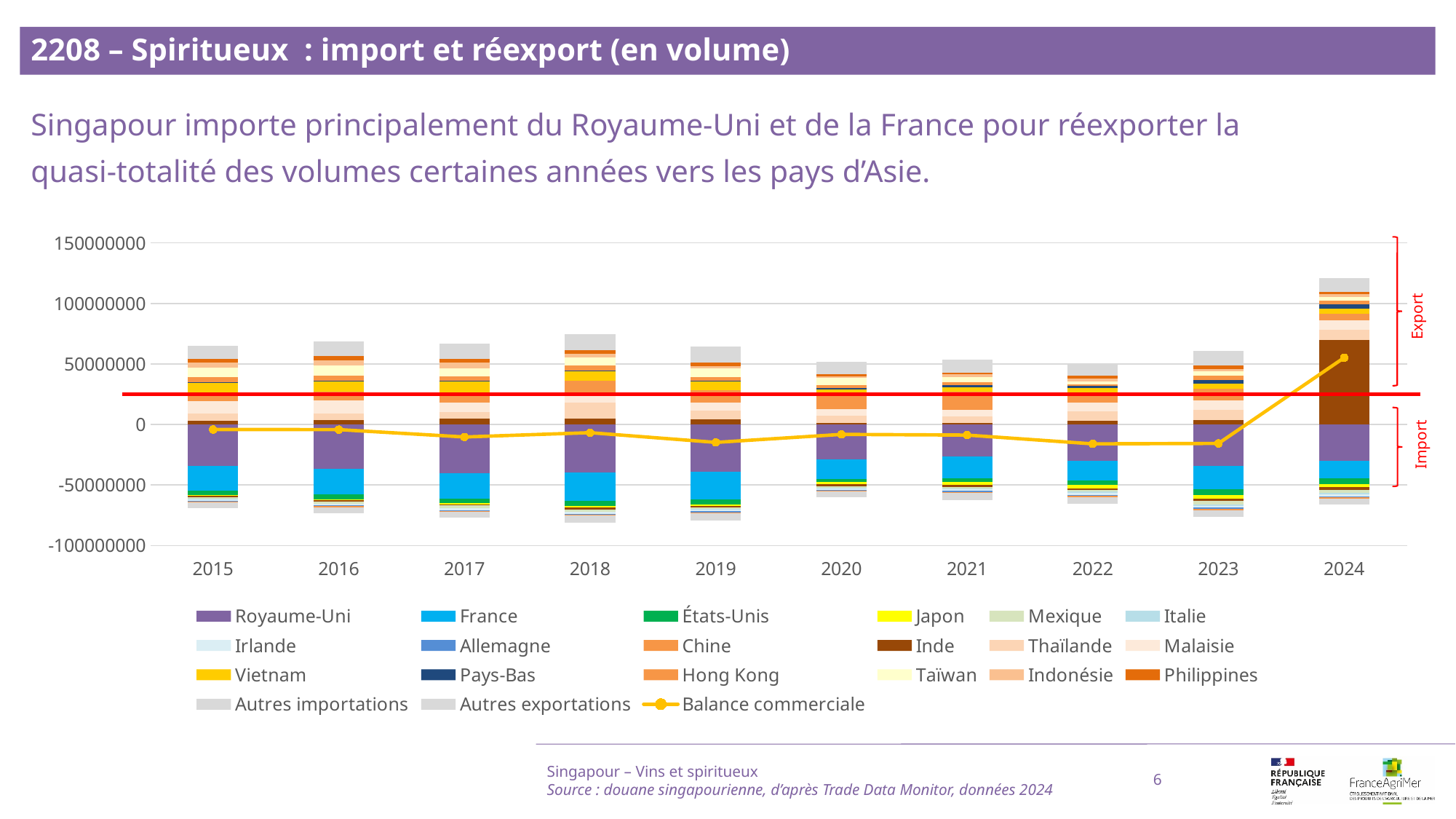
Is the Balance commerciale value for 2024 greater or less than 50000000? greater How many series does the chart legend list? 21 Does the Balance commerciale line rise or fall between 2023 and 2024? rise What kind of chart is shown on the slide? Stacked bar chart with a line Which is larger, the export stacked bar for 2024 or for 2015? 2024 In which year does the Balance commerciale line reach its highest value? 2024 How many years are shown on the x axis of the chart? 10 Which series is drawn as a line rather than as stacked bars? Balance commerciale Is the total export bar for 2024 greater or less than 100000000? greater Which year has the tallest export (positive) stacked bar? 2024 Is the Balance commerciale value for 2015 greater or less than 0? less